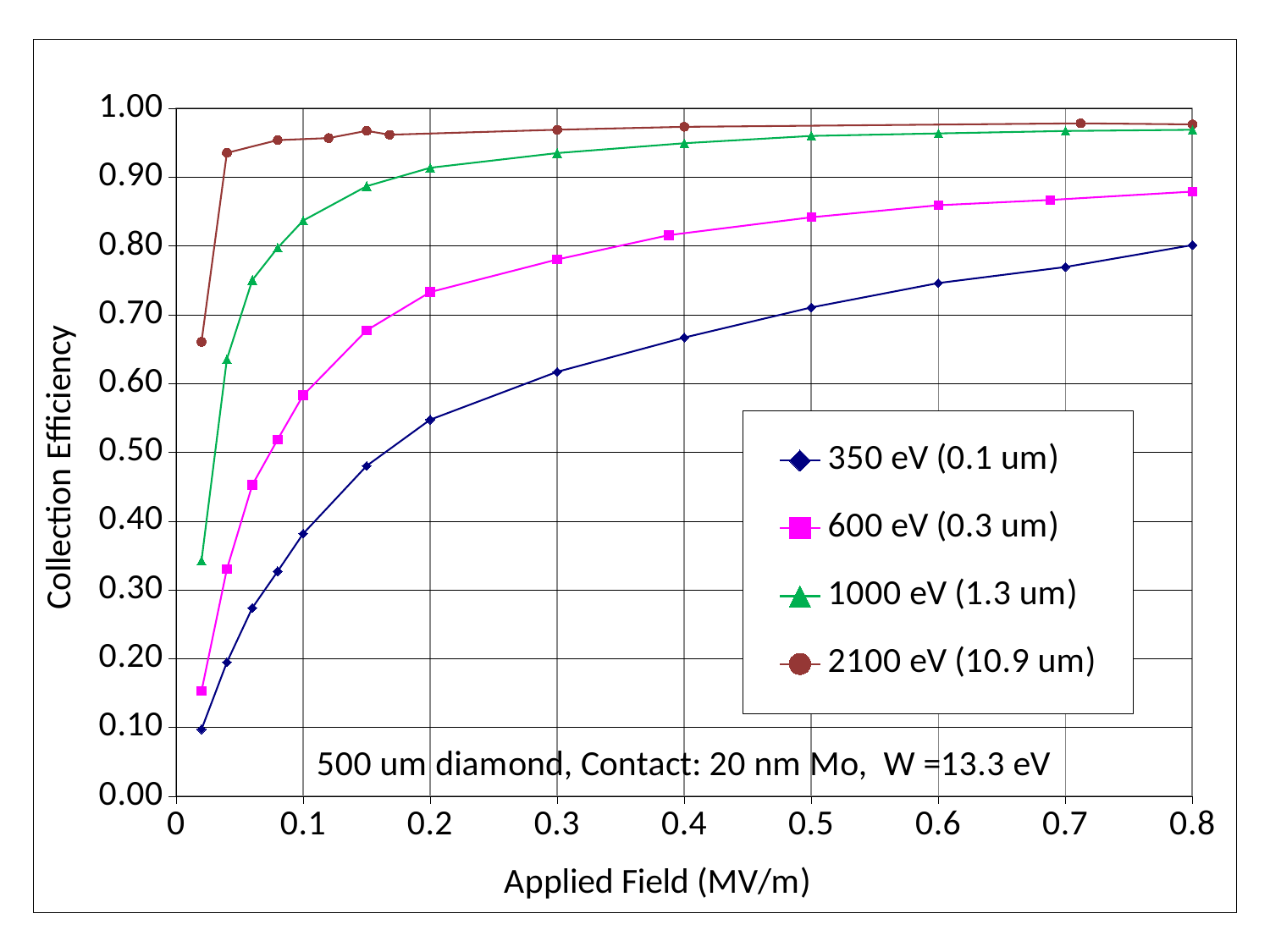
Is the collection efficiency for 350 eV (0.1 um) at 0.2 MV/m greater or less than 0.60? less Does the collection efficiency for 350 eV (0.1 um) rise or fall as the applied field increases? rise Is the collection efficiency for 350 eV (0.1 um) at 0.5 MV/m greater or less than 0.80? less What kind of chart is shown on the slide? line chart Is the collection efficiency for 2100 eV (10.9 um) at 0.02 MV/m greater or less than 0.70? less What is the title of the x axis? Applied Field (MV/m) What is the title of the y axis? Collection Efficiency Which series has the lowest collection efficiency at 0.8 MV/m? 350 eV (0.1 um) At 0.4 MV/m, which series has the higher collection efficiency, 350 eV (0.1 um) or 600 eV (0.3 um)? 600 eV (0.3 um) How many series does the legend list? 4